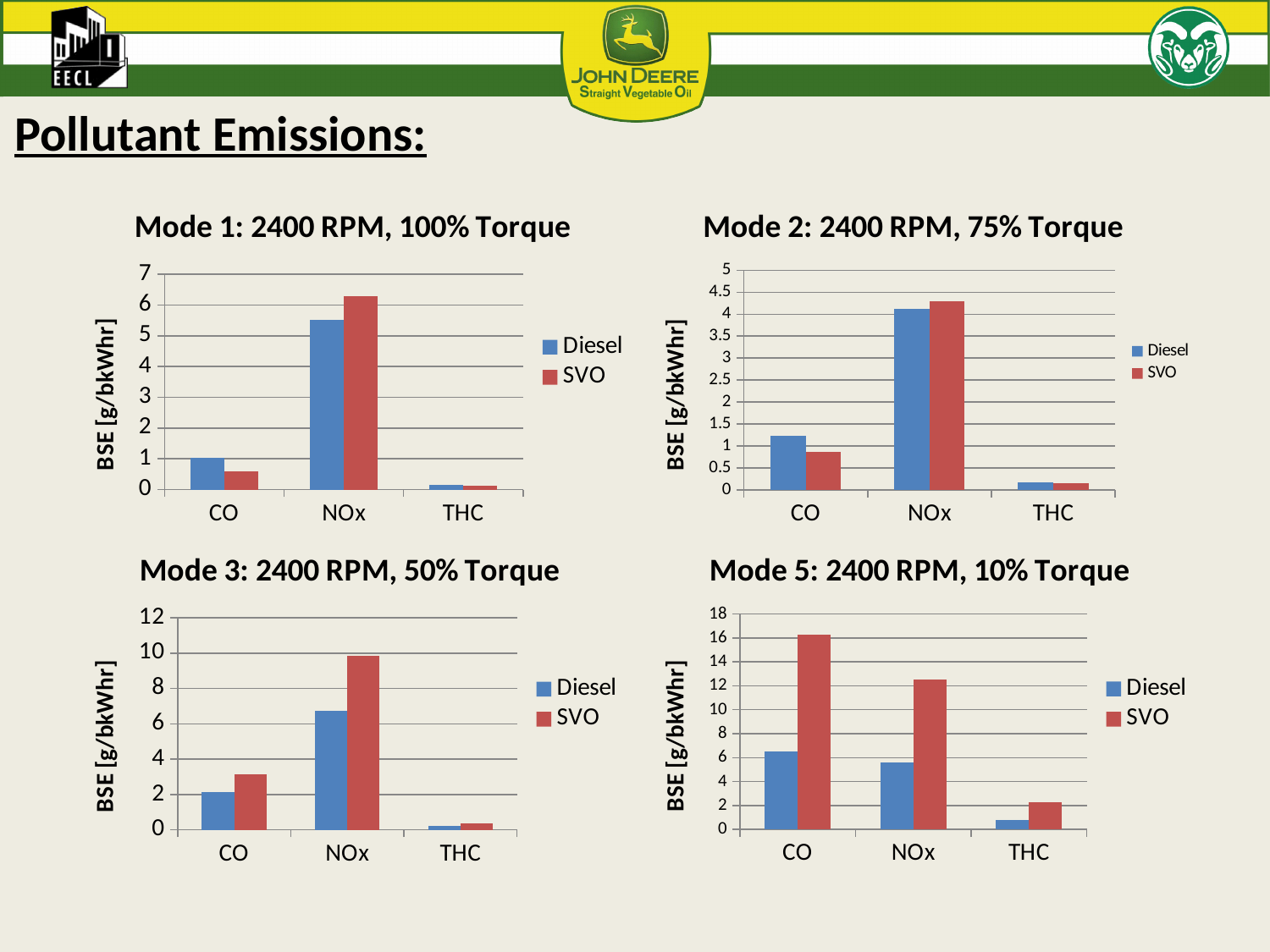
How many pollutant categories are shown on the x axis of the Mode 2: 2400 RPM, 75% Torque chart? 3 In the Mode 5: 2400 RPM, 10% Torque chart, is the SVO value for CO greater or less than 14? greater How many series does the legend of the Mode 3: 2400 RPM, 50% Torque chart list? 2 In the Mode 2: 2400 RPM, 75% Torque chart, which pollutant has the lowest Diesel value? THC In the Mode 2: 2400 RPM, 75% Torque chart, is the Diesel value for CO greater or less than 1? greater In the Mode 3: 2400 RPM, 50% Torque chart, which is larger for NOx, Diesel or SVO? SVO In the Mode 1: 2400 RPM, 100% Torque chart, is the Diesel value for NOx greater or less than 5? greater In the Mode 1: 2400 RPM, 100% Torque chart, which is larger for CO, Diesel or SVO? Diesel In the Mode 1: 2400 RPM, 100% Torque chart, which pollutant has the highest SVO value? NOx In the Mode 5: 2400 RPM, 10% Torque chart, which pollutant has the highest SVO value? CO